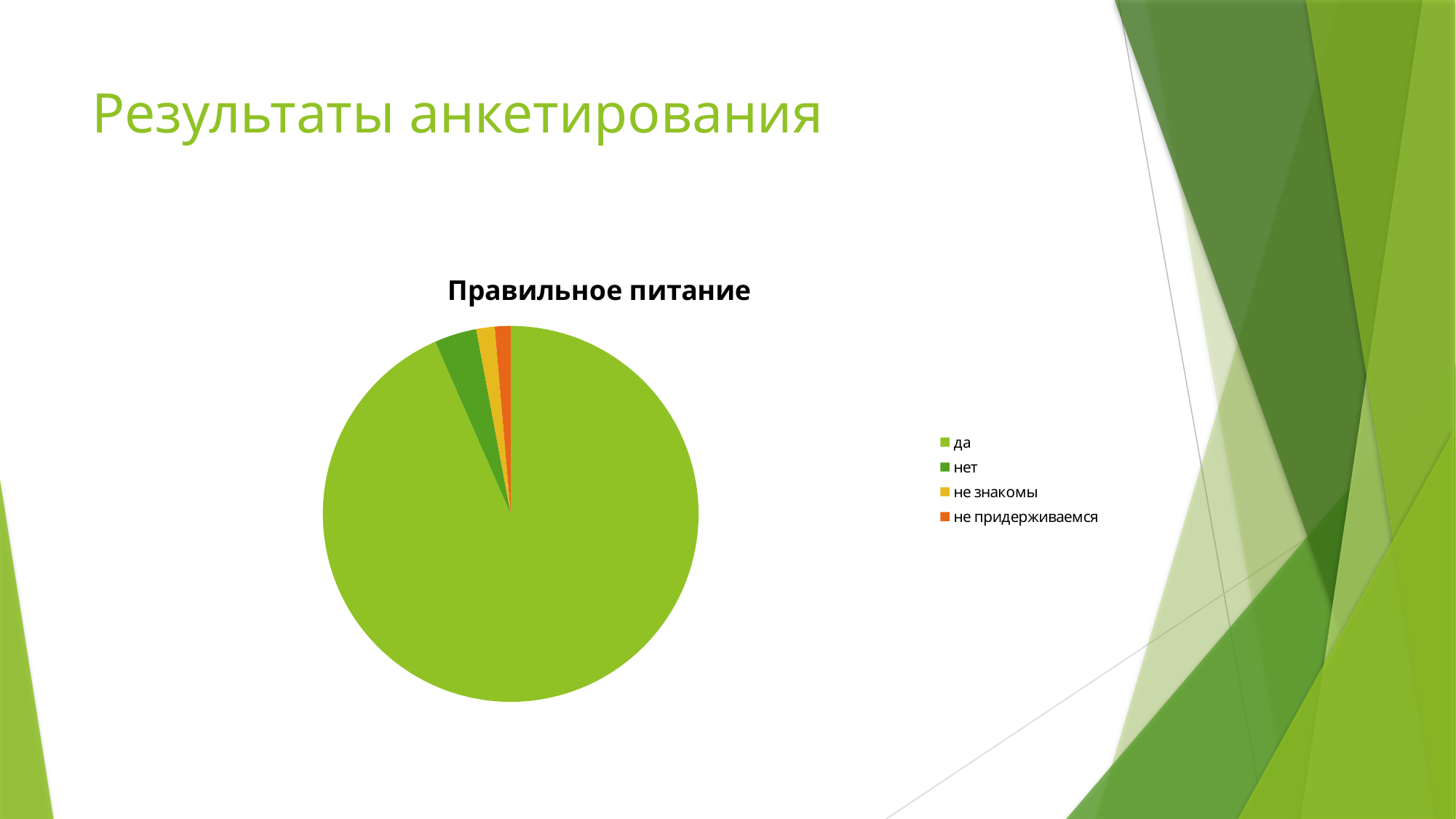
What kind of chart is shown on the slide? pie chart Which is larger, the slice for нет or the slice for не придерживаемся? нет Which is larger, the slice for да or the slice for нет? да Which category has the largest slice of the pie? да Which category is shown in orange in the legend? не придерживаемся How many categories does the pie chart have? 4 Does the slice for да take up more or less than half of the pie? more What is the title of the chart? Правильное питание Which is larger, the slice for нет or the slice for не знакомы? нет